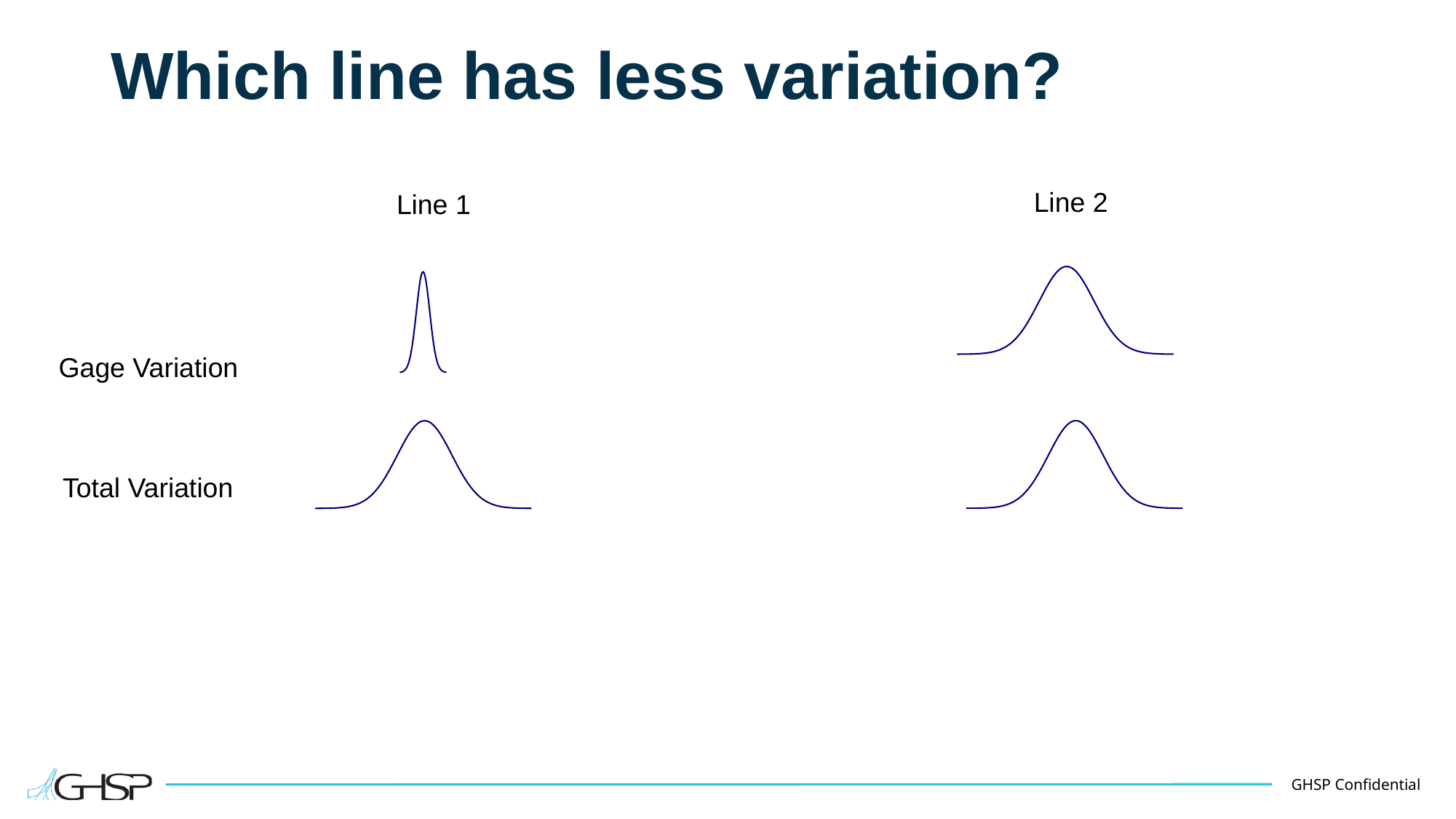
Which line's Gage Variation curve is narrower, Line 1 or Line 2? Line 1 Which line's Gage Variation curve is wider, Line 1 or Line 2? Line 2 What are the two row labels on the left of the curves? Gage Variation, Total Variation How many bell-shaped curves are drawn on the slide? 4 What are the two column headings above the curves? Line 1, Line 2